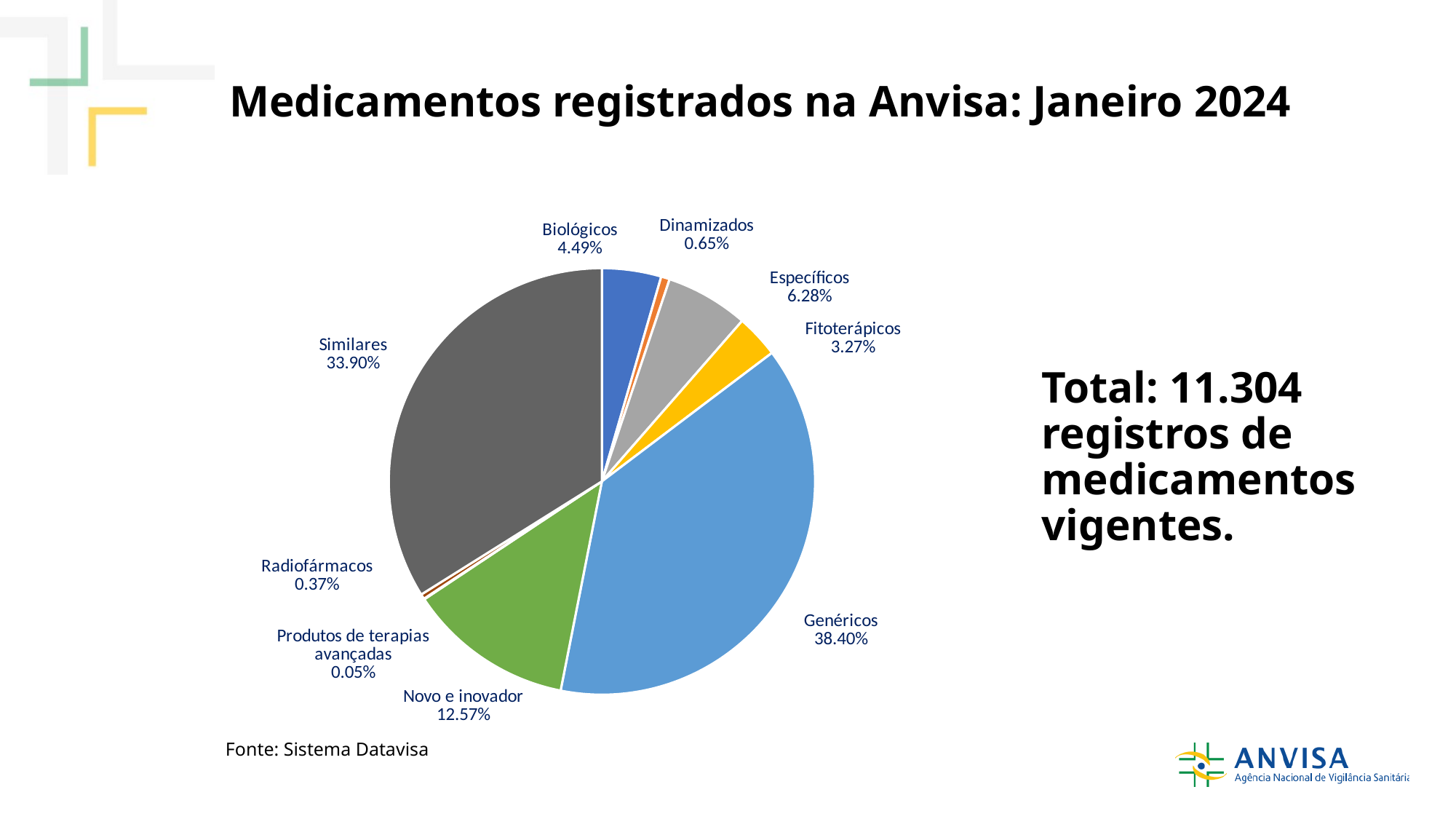
Which category has the largest slice of the pie? Genéricos What is the value shown for Similares? 33.90% What is the total number of registrations stated on the slide? 11.304 What type of chart is shown on the slide? Pie chart Which is larger, the share for Específicos or the share for Biológicos? Específicos What share of the pie does Genéricos represent? 38.40% How many categories are shown in the pie chart? 9 What is the title of the slide containing the chart? Medicamentos registrados na Anvisa: Janeiro 2024 Which category has the smallest slice of the pie? Produtos de terapias avançadas What is the value shown for Produtos de terapias avançadas? 0.05% What is the difference between the shares of Genéricos and Similares? 4.50% What percentage is shown for Novo e inovador? 12.57%